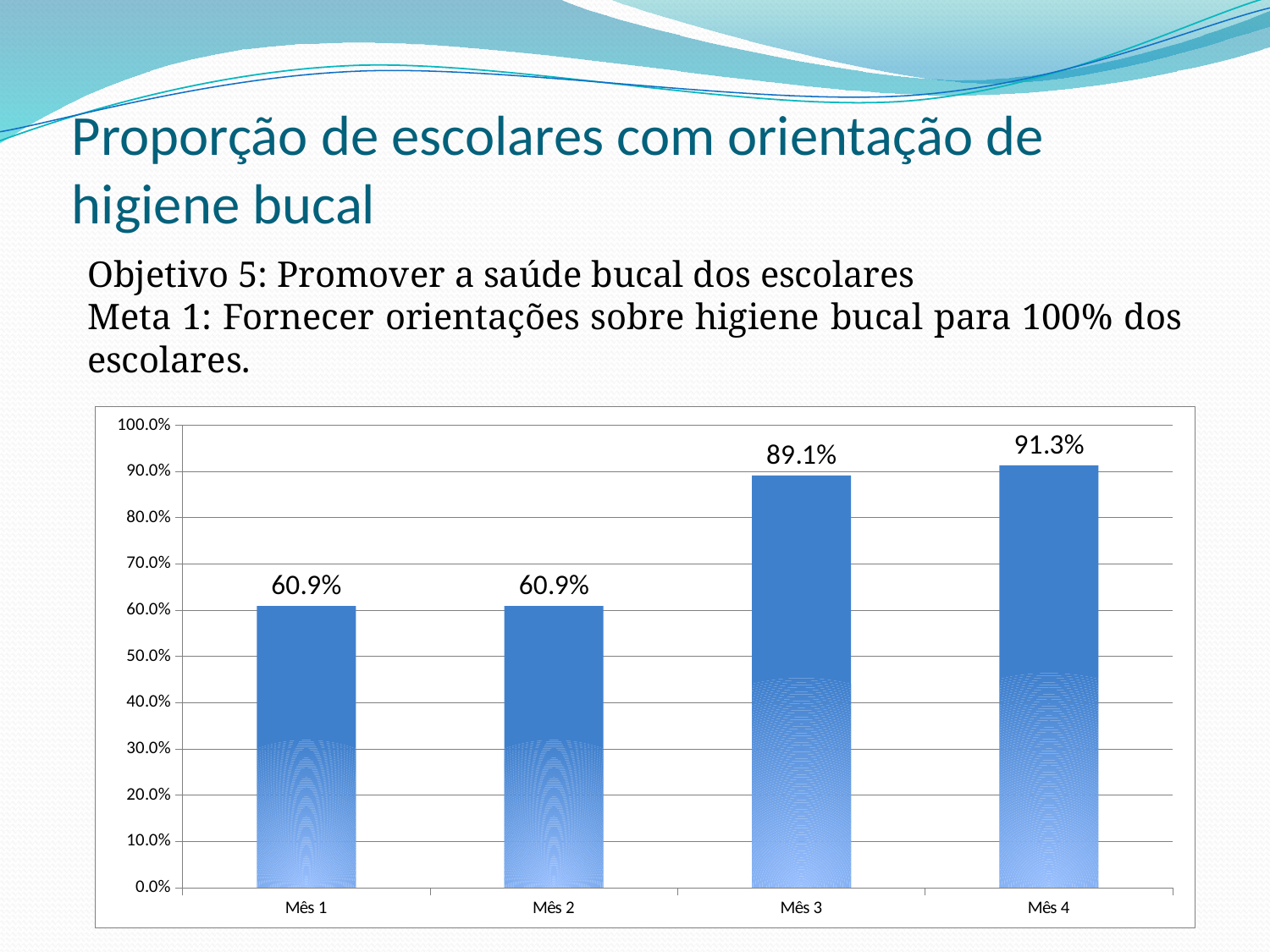
What is the value for Mês 4? 91.3% Is the value for Mês 1 greater or less than 50.0%? greater Which is larger, the value for Mês 2 or the value for Mês 3? Mês 3 Which month has the highest value? Mês 4 What is the difference between the values for Mês 4 and Mês 3? 2.2% How many months are shown on the x axis? 4 What is the value for Mês 1? 60.9% What is the difference between the values for Mês 3 and Mês 2? 28.2% Do the values rise or fall from Mês 2 to Mês 4? Rise What kind of chart is shown on the slide? Bar chart What is the value for Mês 3? 89.1% Is the value for Mês 4 greater or less than 100.0%? less